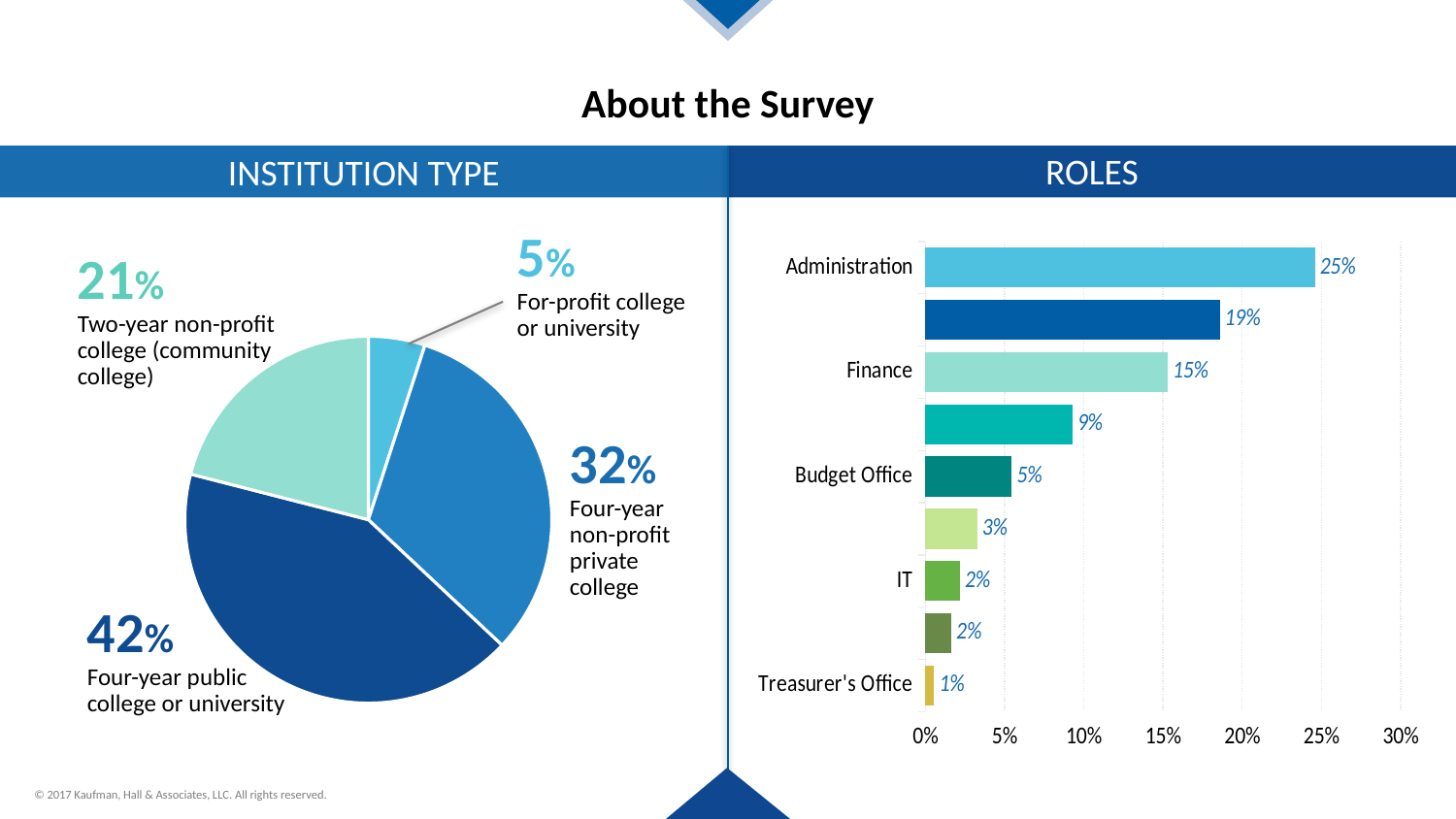
On the INSTITUTION TYPE chart, what share of respondents are from a four-year public college or university? 42% On the ROLES chart, what is the value for Finance? 15% What kind of chart is the ROLES chart? Bar chart On the ROLES chart, which is larger, the value for Budget Office or the value for IT? Budget Office On the ROLES chart, what is the value for Administration? 25% What kind of chart is the INSTITUTION TYPE chart? Pie chart On the ROLES chart, what is the value for Treasurer's Office? 1% On the INSTITUTION TYPE chart, which institution type has the smallest share? For-profit college or university On the INSTITUTION TYPE chart, what share of respondents are from a for-profit college or university? 5% On the ROLES chart, what is the difference in percentage points between Administration and Finance? 10 On the INSTITUTION TYPE chart, which institution type has the largest share? Four-year public college or university On the INSTITUTION TYPE chart, what is the difference in percentage points between the four-year public college share and the four-year non-profit private college share? 10